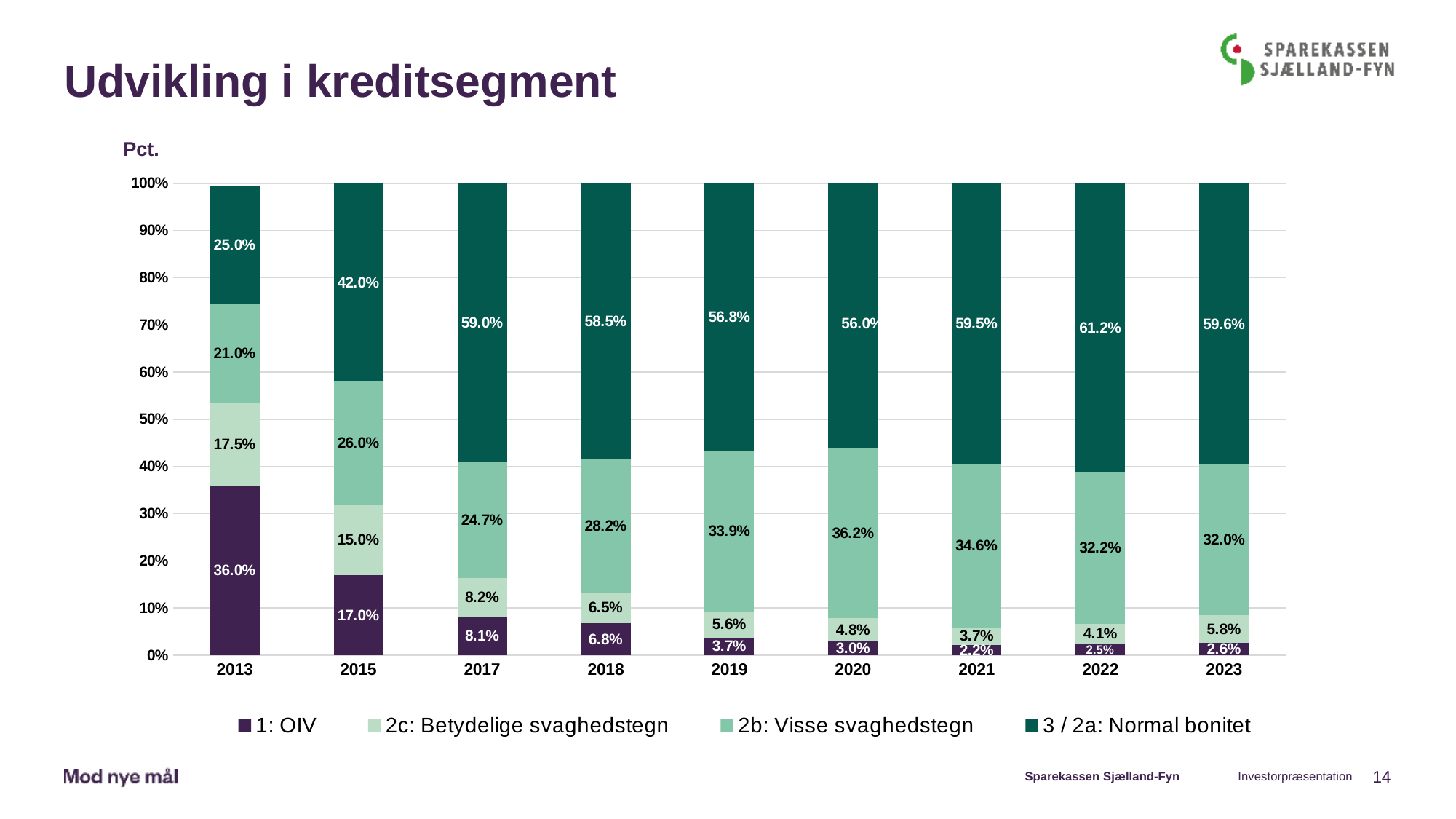
In which year is the share of 1: OIV lowest? 2021 What is the value for 3 / 2a: Normal bonitet in 2022? 61.2% How many series does the legend list? 4 What is the value for 2b: Visse svaghedstegn in 2020? 36.2% What is the value for 1: OIV in 2013? 36.0% In which year is the share of 3 / 2a: Normal bonitet highest? 2022 What is the value for 2c: Betydelige svaghedstegn in 2015? 15.0% Does the share of 1: OIV rise or fall from 2013 to 2023? Fall Which year has the larger value for 2c: Betydelige svaghedstegn, 2017 or 2018? 2017 How many years are shown on the x axis? 9 By how many percentage points did 1: OIV fall from 2013 to 2015? 19.0% What kind of chart is shown on the slide? Stacked bar chart